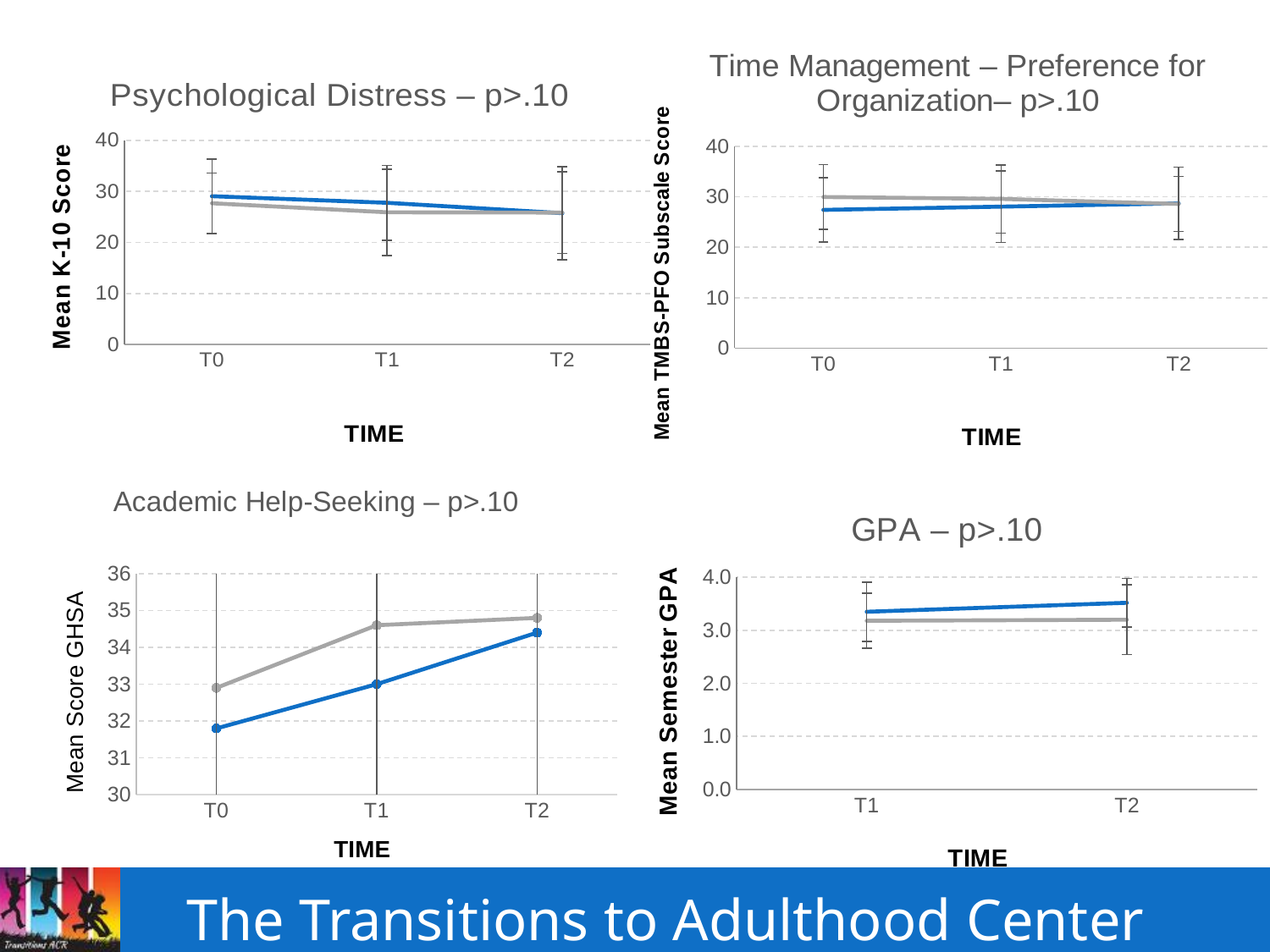
What kind of chart is the 'Psychological Distress – p>.10' chart? line chart In the 'Academic Help-Seeking – p>.10' chart, is the value of the blue line at T0 greater or less than 32? less In the 'Academic Help-Seeking – p>.10' chart, is the value of the gray line at T1 greater or less than 34? greater What is the y-axis label of the 'Psychological Distress – p>.10' chart? Mean K-10 Score In the 'GPA – p>.10' chart, is the value of the blue line at T2 greater or less than 3.0? greater How many time points are shown on the x axis of the 'Academic Help-Seeking – p>.10' chart? 3 What is the y-axis label of the 'GPA – p>.10' chart? Mean Semester GPA In the 'Academic Help-Seeking – p>.10' chart, which line is higher at T0, the gray line or the blue line? gray line In the 'Academic Help-Seeking – p>.10' chart, does the blue line rise or fall from T0 to T2? rise How many time points are shown on the x axis of the 'GPA – p>.10' chart? 2